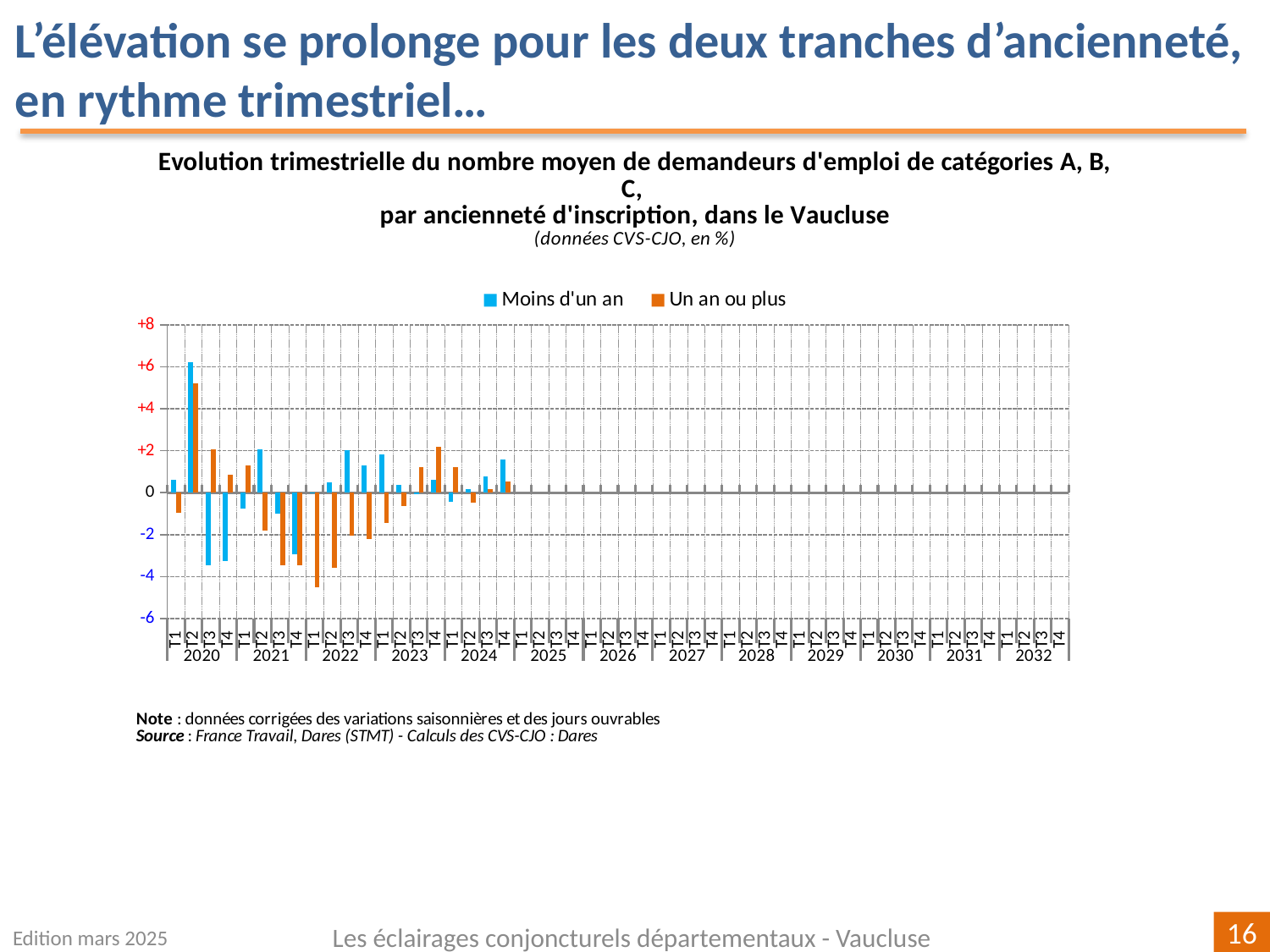
Is the value for 'Un an ou plus' in T2 2020 greater or less than +4? greater In which quarter does the 'Moins d'un an' series reach its highest value? T2 2020 Which series is shown in orange in the legend? Un an ou plus In T2 2020, which series has the larger value, 'Moins d'un an' or 'Un an ou plus'? Moins d'un an In which quarter does the 'Un an ou plus' series reach its lowest value? T1 2022 What kind of chart is shown on the slide? Bar chart Is the value for 'Moins d'un an' in T2 2020 greater or less than +4? greater In which quarter does the 'Un an ou plus' series reach its highest value? T2 2020 How many series does the legend list? 2 Which series is shown in blue in the legend? Moins d'un an Is the value for 'Un an ou plus' in T1 2021 greater or less than -2? greater